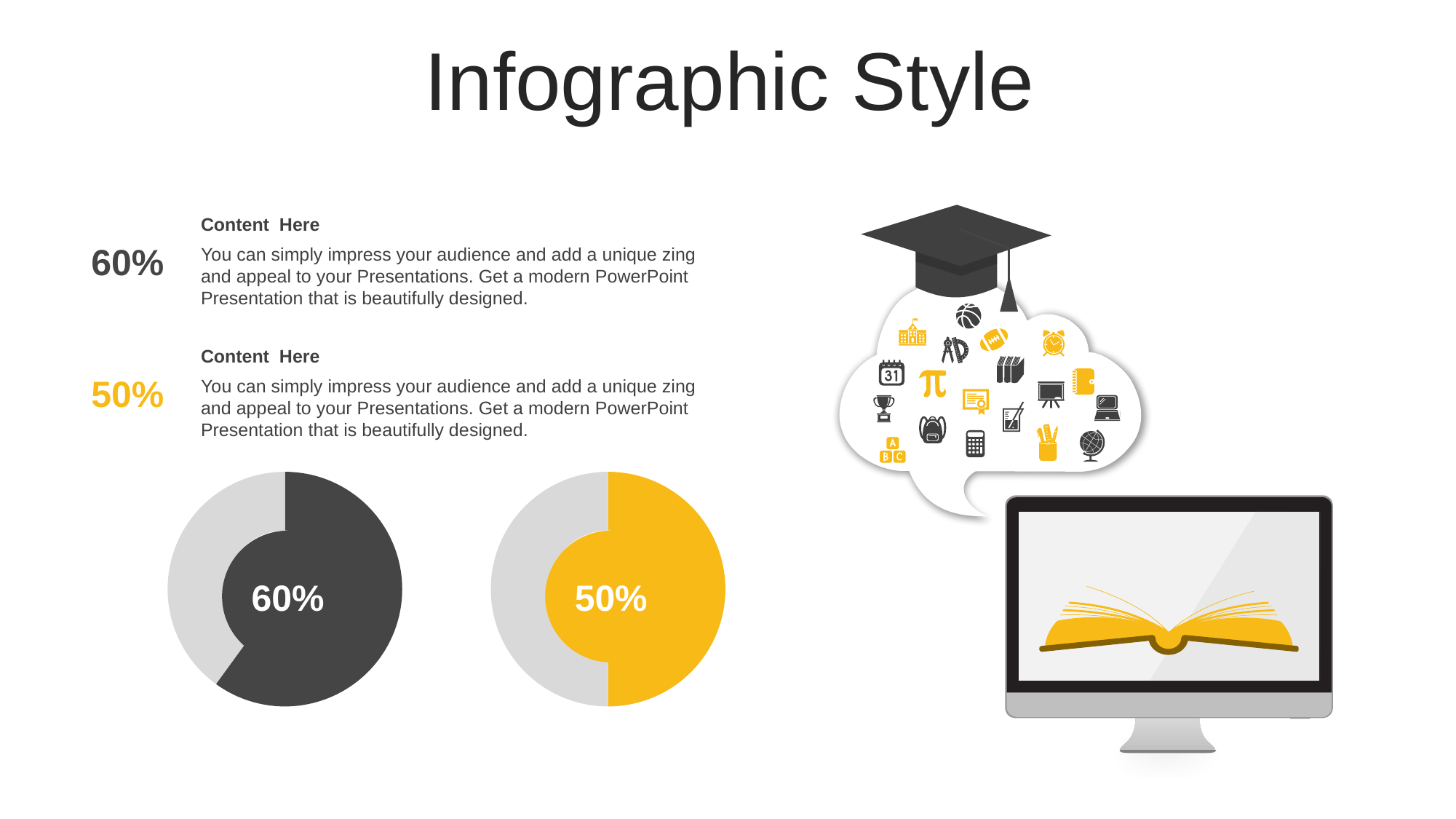
What kind of chart is the left chart on the slide? doughnut chart What colour is the highlighted slice on the right pie chart? yellow Which pie chart shows the larger highlighted share, the left or the right? left On the left pie chart, what share of the pie does the dark grey slice represent? 60% What value is printed on the left pie chart? 60% Is the value shown on the left pie chart greater or less than 50%? greater What colour is the highlighted slice on the left pie chart? dark grey What value is printed on the right pie chart? 50% What kind of chart is the right chart on the slide? doughnut chart What is the difference between the value on the left pie chart and the value on the right pie chart? 10% How many pie charts are shown on the slide? 2 On the right pie chart, what share of the pie does the yellow slice represent? 50%